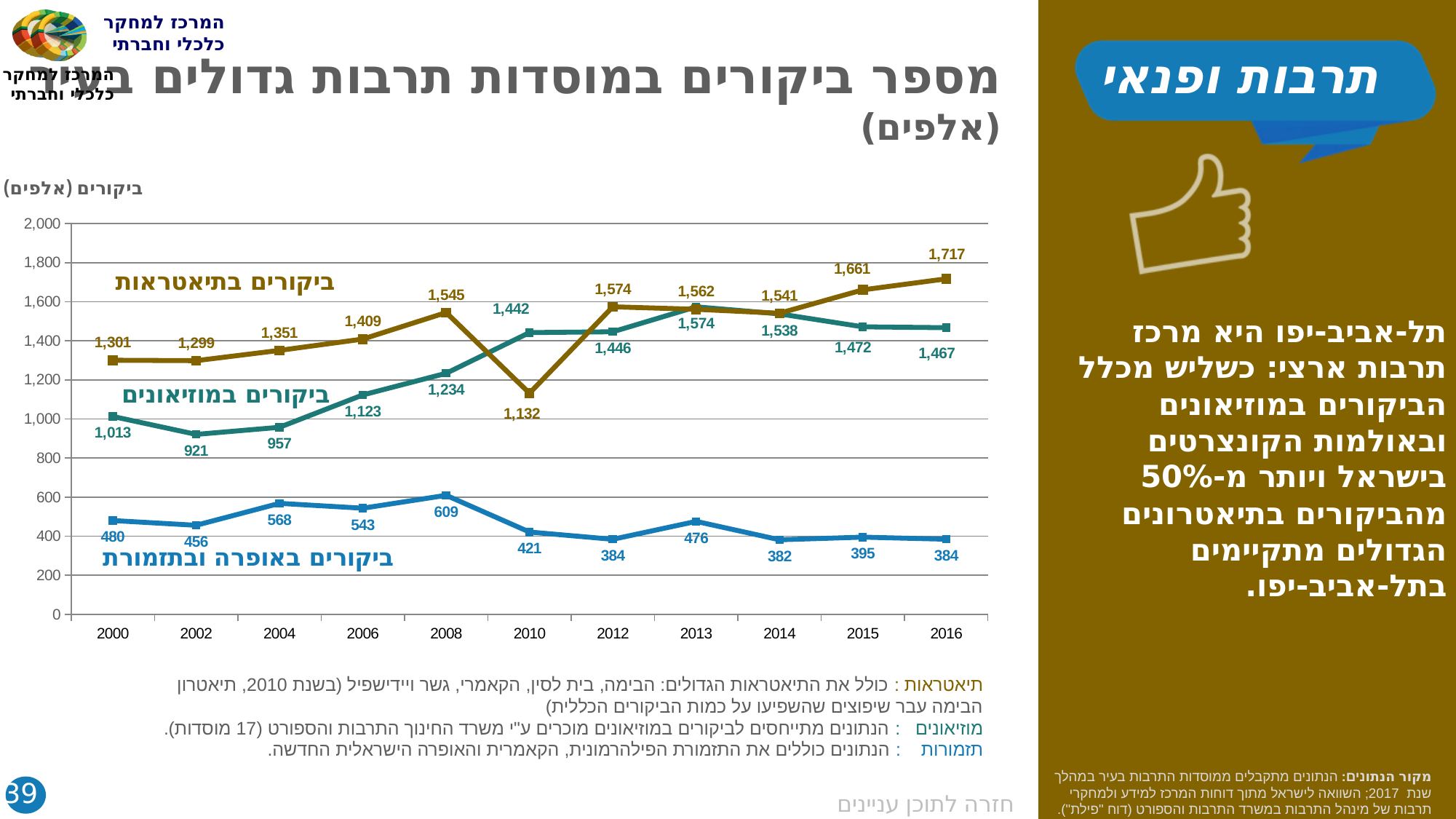
In which year is the value for ביקורים באופרה ובתזמורת highest? 2008 In which year is the value for ביקורים בתיאטראות lowest? 2010 How many years are plotted along the x axis? 11 What is the value for ביקורים במוזיאונים in 2010? 1,442 What kind of chart is shown on the slide? line chart What is the label of the y axis? ביקורים (אלפים) How many series does the chart show? 3 What is the value for ביקורים בתיאטראות in 2016? 1,717 Does the value for ביקורים במוזיאונים rise or fall from 2000 to 2013? rise Which is larger in 2010: ביקורים במוזיאונים or ביקורים בתיאטראות? ביקורים במוזיאונים What is the value for ביקורים באופרה ובתזמורת in 2008? 609 What is the difference between the ביקורים בתיאטראות values in 2016 and 2000? 416